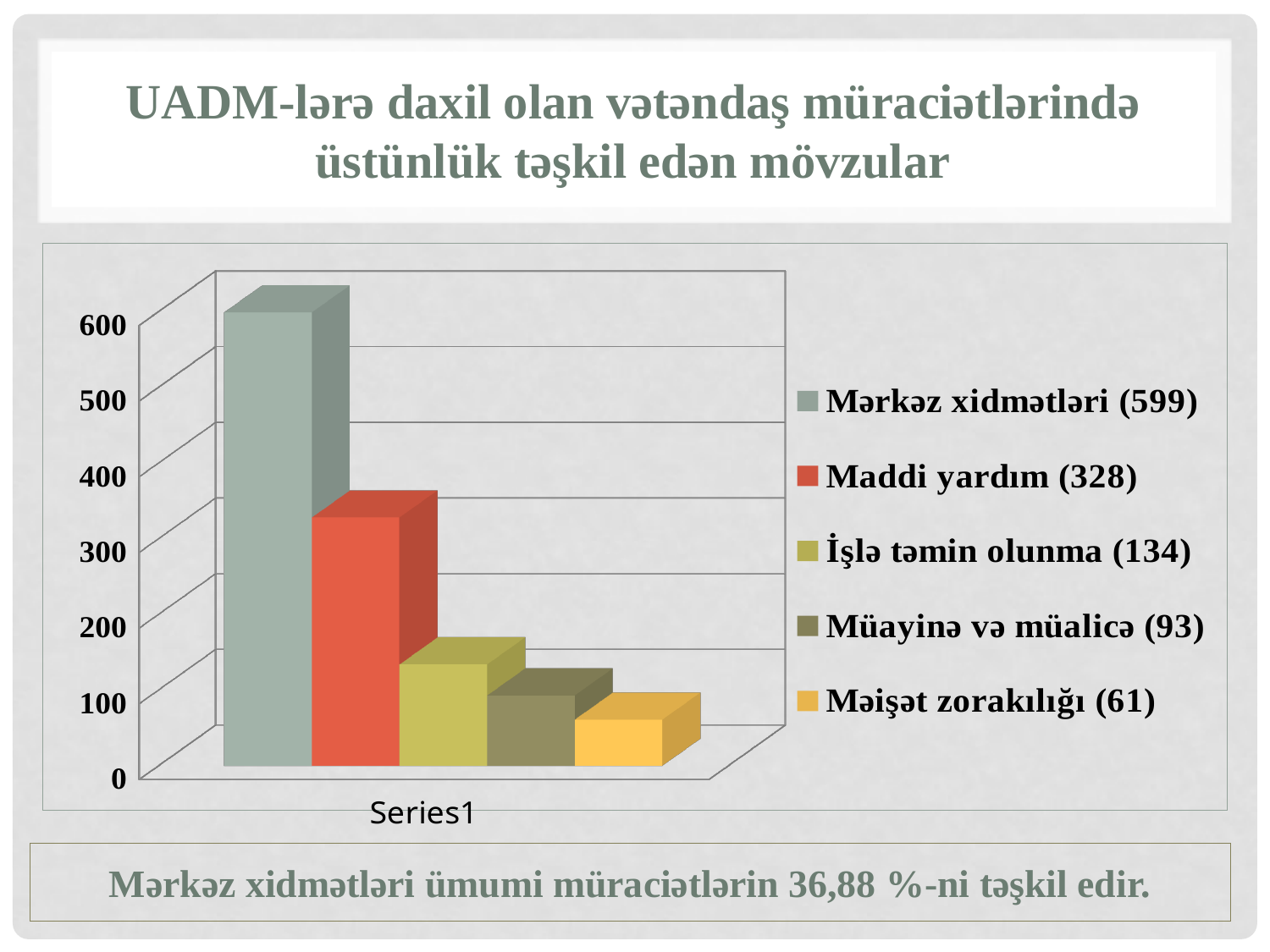
What value is shown for Maddi yardım? 328 Is the value for Maddi yardım greater or less than 300? greater What value is shown for Məişət zorakılığı? 61 Which topic has the highest value? Mərkəz xidmətləri What kind of chart is shown on the slide? Bar chart What value is shown for Mərkəz xidmətləri in the legend? 599 What is the difference between the values for Müayinə və müalicə and Məişət zorakılığı? 32 Which is larger, the value for İşlə təmin olunma or the value for Müayinə və müalicə? İşlə təmin olunma How many series does the legend list? 5 What value is shown for İşlə təmin olunma? 134 Which topic has the lowest value? Məişət zorakılığı What is the difference between the values for Mərkəz xidmətləri and Maddi yardım? 271